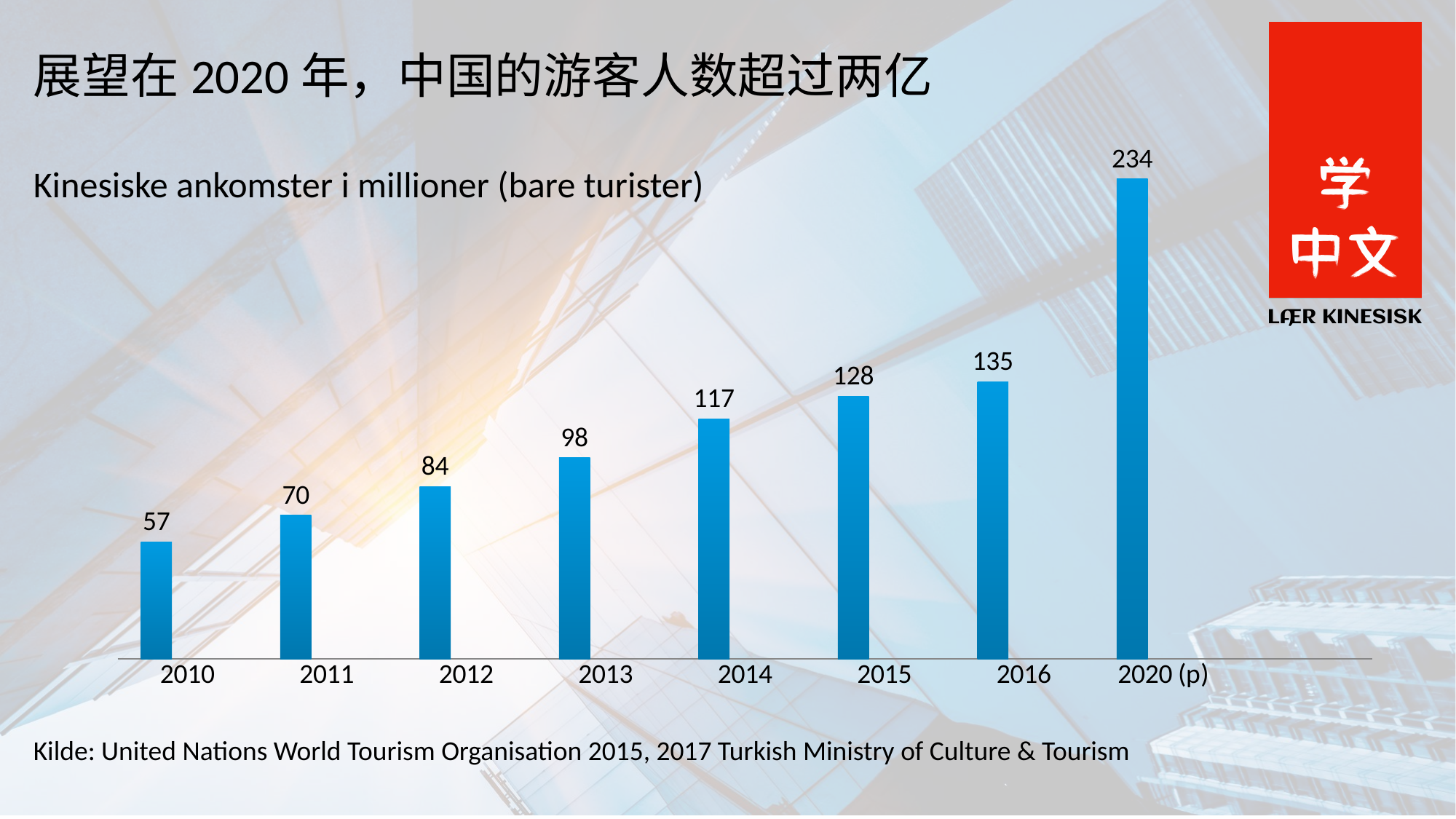
What is the value for 2020 (p)? 234 What is the difference between the values for 2016 and 2015? 7 Which year has the highest value? 2020 (p) What is the value for 2010? 57 What is the value for 2014? 117 What is the difference between the values for 2020 (p) and 2016? 99 Which year has the lowest value? 2010 What kind of chart is this? bar chart What is the subtitle text above the chart? Kinesiske ankomster i millioner (bare turister) Do the values rise or fall from 2010 to 2020 (p)? rise Which is larger, the value for 2012 or the value for 2013? 2013 How many years are shown on the x axis? 8